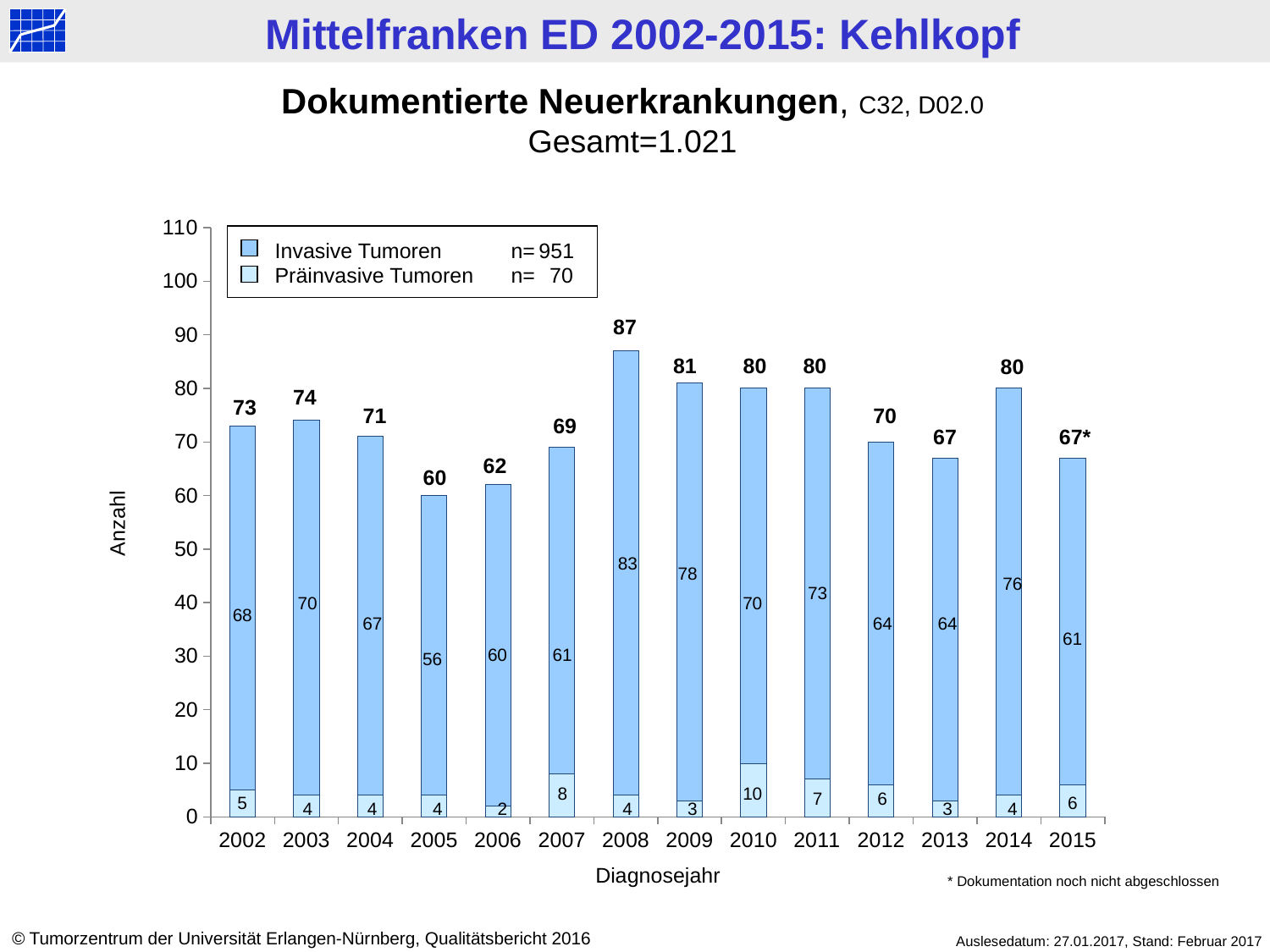
How many years (categories) are shown on the x axis? 14 What is the total of the stacked bar for 2007 (invasive plus pre-invasive)? 69 How many invasive tumours (Invasive Tumoren) were documented in 2011? 73 How many pre-invasive tumours (Präinvasive Tumoren) were documented in 2010? 10 Which year has the lowest total number of new cases? 2005 Which year has the highest total number of new cases? 2008 How many series does the legend list? 2 What is the total number of documented new cases in 2008? 87 According to the legend, what is the n for Präinvasive Tumoren? 70 Which year has more invasive tumours, 2009 or 2014? 2009 What is the difference between the total for 2008 and the total for 2005? 27 What kind of chart is shown on the slide? Stacked bar chart